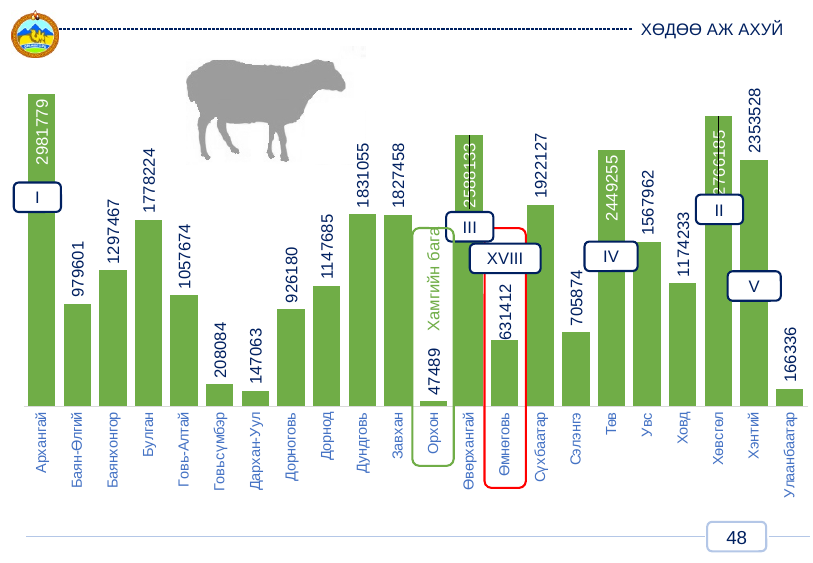
What is the value for Өмнөговь? 631412 How many provinces (categories) are shown in the chart? 22 What is the difference between the values for Булган and Баянхонгор? 480757 Which province has the highest value in the chart? Архангай What is the value for Хэнтий? 2353528 What is the difference between the values for Архангай and Орхон? 2934290 Which province has the lowest value in the chart? Орхон What is the value for Орхон? 47489 What is the value for Архангай? 2981779 What is the value for Сүхбаатар? 1922127 Which is larger, the value for Төв or the value for Хэнтий? Төв What type of chart is shown on the slide? bar chart